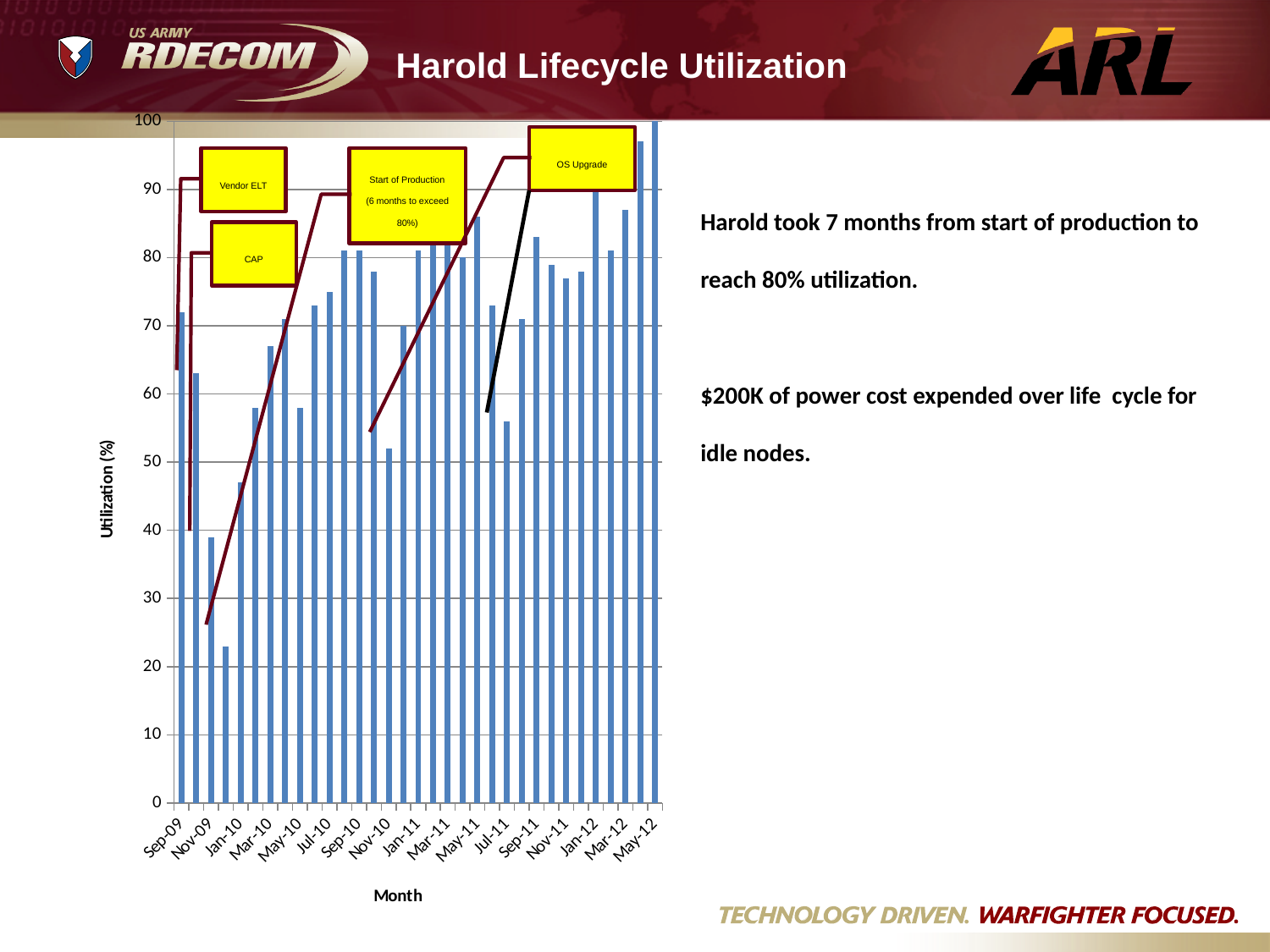
What is the label of the vertical axis? Utilization (%) Is the utilization for Jul-10 greater or less than 70? greater Is the utilization for Nov-10 greater or less than 60? less What is the utilization value for May-12? 100 What is the label of the horizontal axis? Month Which month has higher utilization, Sep-09 or Nov-09? Sep-09 Is the utilization for Jan-10 greater or less than 50? less What kind of chart is shown on the slide? bar chart Which month has higher utilization, Mar-11 or Jul-11? Mar-11 Which month has the highest utilization? May-12